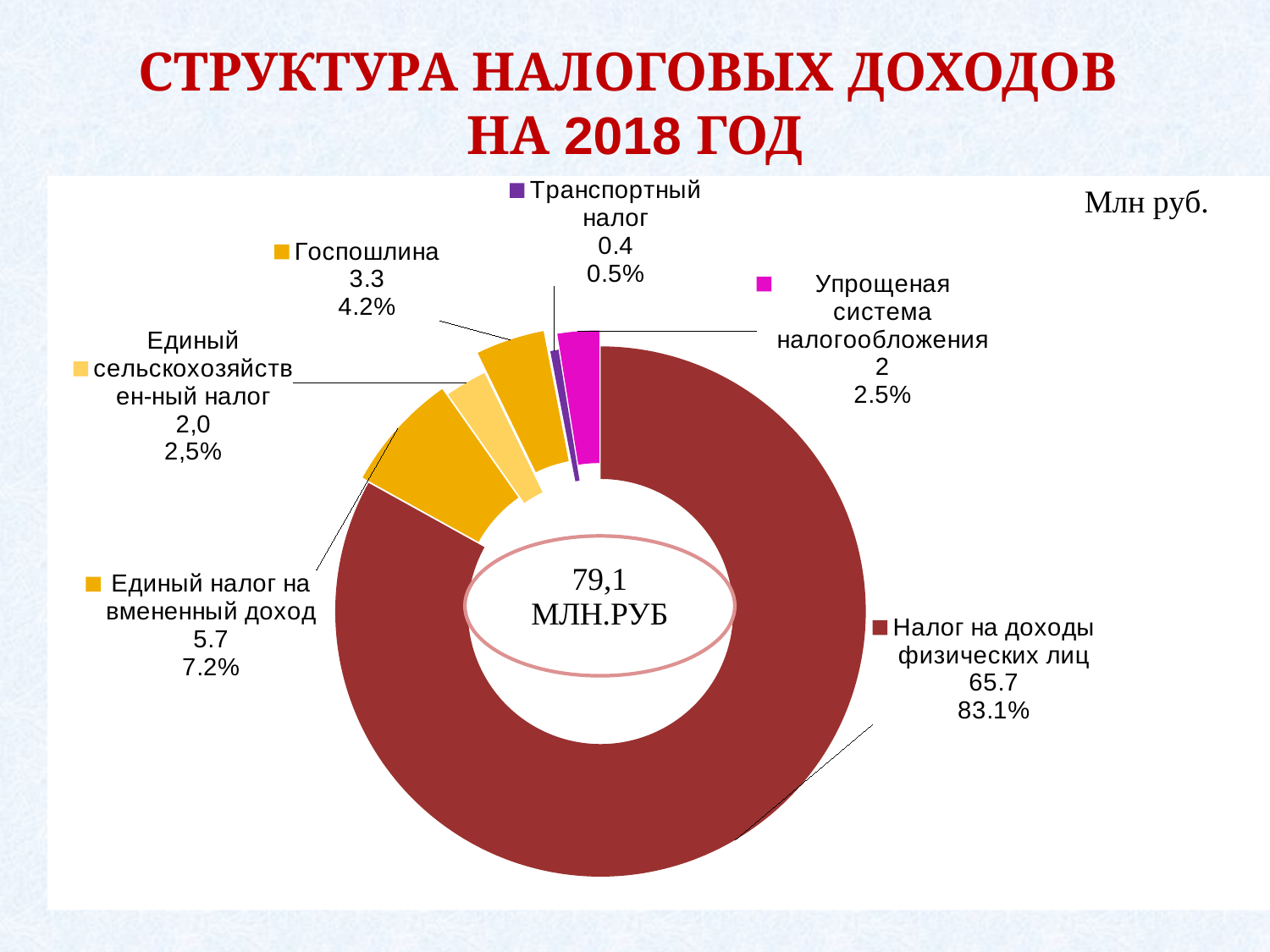
Which category has the largest value? Налог на доходы физических лиц Which category has the smallest value? Транспортный налог What share of the chart does Госпошлина represent? 4.2% What is the value for Налог на доходы физических лиц? 65.7 What is the difference between the values for Единый налог на вмененный доход and Госпошлина? 2.4 What is the value for Единый налог на вмененный доход? 5.7 What total is printed in the centre of the doughnut? 79,1 МЛН.РУБ Which is larger, the value for Госпошлина or the value for Упрощеная система налогообложения? Госпошлина What share of the chart does Налог на доходы физических лиц represent? 83.1% What type of chart is shown on the slide? doughnut chart How many categories are shown in the chart? 6 What is the value for Транспортный налог? 0.4